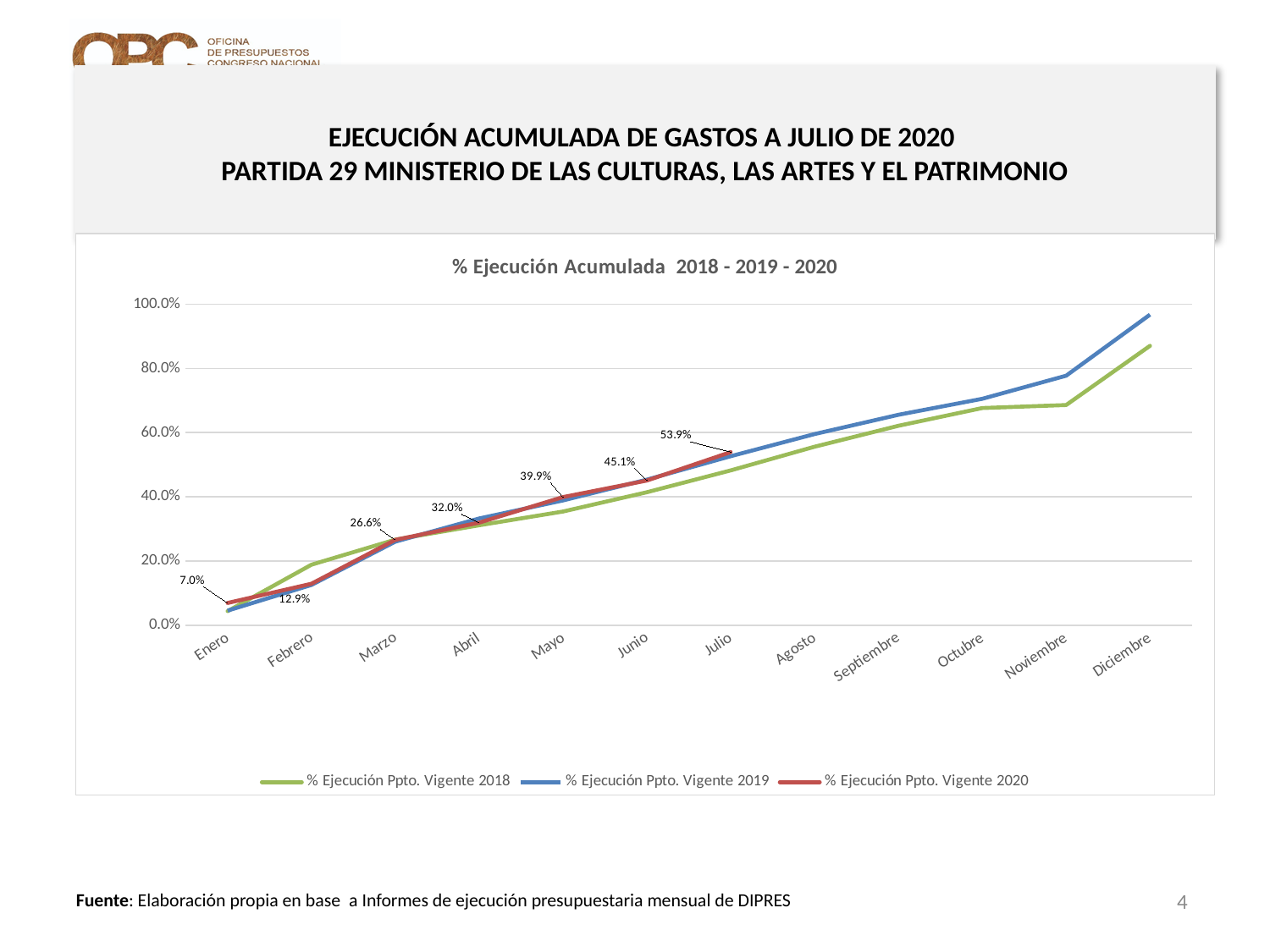
What is the value for % Ejecución Ppto. Vigente 2020 in Marzo? 26.6% What is the value for % Ejecución Ppto. Vigente 2020 in Enero? 7.0% Do the values for % Ejecución Ppto. Vigente 2019 rise or fall from Enero to Diciembre? Rise What is the title of the chart? % Ejecución Acumulada 2018 - 2019 - 2020 In Diciembre, which series is higher: % Ejecución Ppto. Vigente 2018 or % Ejecución Ppto. Vigente 2019? % Ejecución Ppto. Vigente 2019 Is the value for % Ejecución Ppto. Vigente 2019 in Diciembre greater or less than 80%? greater What kind of chart is shown on the slide? Line chart What is the value for % Ejecución Ppto. Vigente 2020 in Mayo? 39.9% What is the value for % Ejecución Ppto. Vigente 2020 in Julio? 53.9% By how many percentage points did % Ejecución Ppto. Vigente 2020 increase from Junio to Julio? 8.8 How many months are shown on the x axis? 12 How many series does the legend list? 3